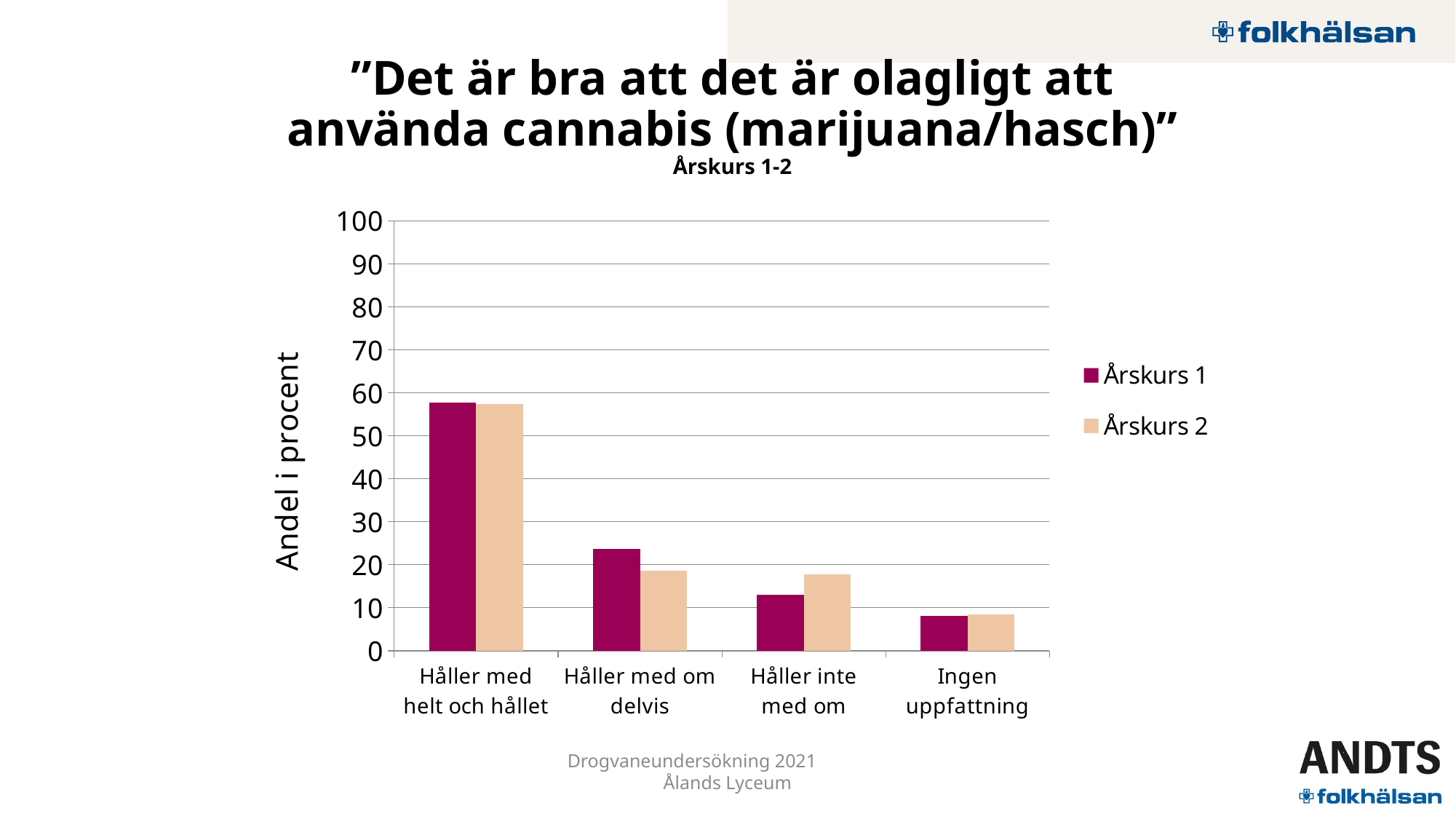
What kind of chart is shown on the slide? bar chart For 'Håller inte med om', which series has the larger value, Årskurs 1 or Årskurs 2? Årskurs 2 Do the Årskurs 1 values rise or fall from left to right along the x axis? fall Is the value for Årskurs 2 in 'Håller med om delvis' greater or less than 20? less How many series does the legend list? 2 Which category has the lowest value for Årskurs 2? Ingen uppfattning How many response categories are shown on the x axis? 4 What is the title of the y axis? Andel i procent For 'Håller med om delvis', which series has the larger value, Årskurs 1 or Årskurs 2? Årskurs 1 Which category has the lowest value for Årskurs 1? Ingen uppfattning Which category has the highest value for Årskurs 1? Håller med helt och hållet Is the value for Årskurs 1 in 'Håller med helt och hållet' greater or less than 50? greater